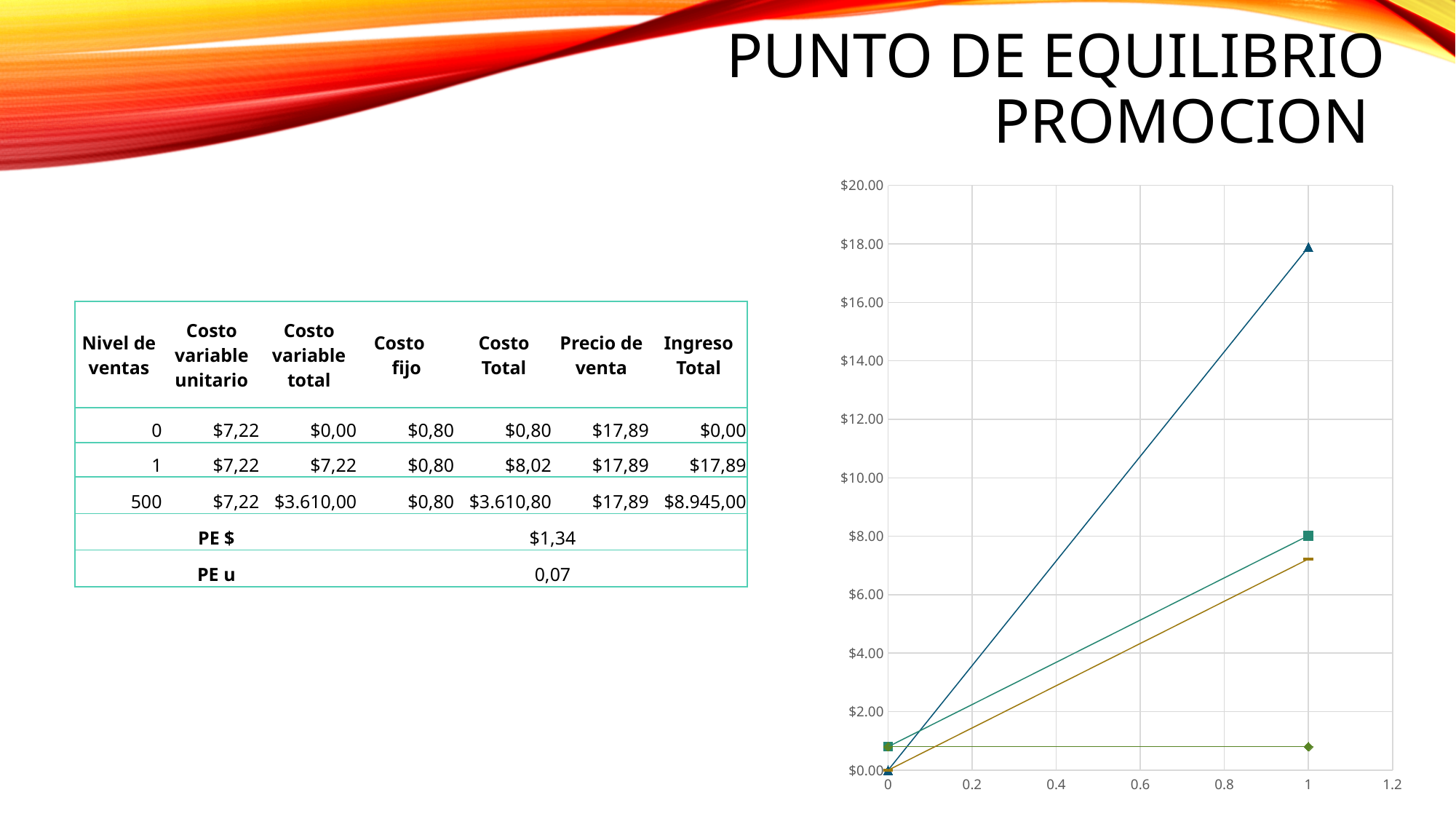
Which line has the lowest value at x = 1? the line with diamond markers What kind of chart is shown on the right of the slide? line chart At x = 1, which is higher: the line with square markers or the line with dash markers? the line with square markers Is the value of the line with square markers at x = 1 greater or less than $6.00? greater Does the chart display a legend? No How many lines are plotted on the chart? 4 Does the line with triangle markers rise or fall from x = 0 to x = 1? rise Is the value of the line with triangle markers at x = 1 greater or less than $16.00? greater Is the value of the line with diamond markers at x = 1 greater or less than $2.00? less Which line reaches the highest value at x = 1? the line with triangle markers What is the highest value shown on the chart's vertical axis? $20.00